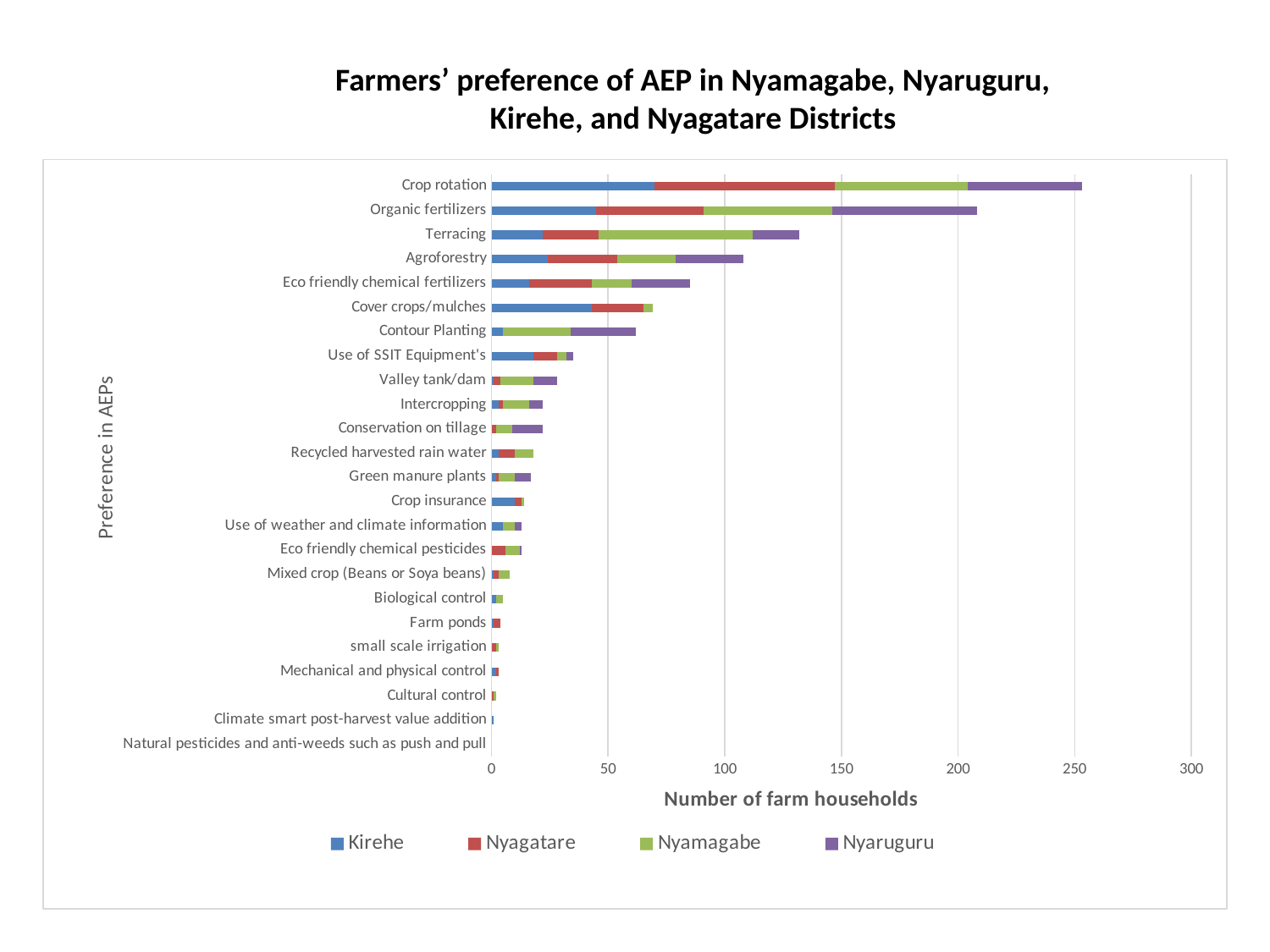
What kind of chart is shown on the slide? Stacked bar chart Which practice has the highest total number of farm households? Crop rotation Which has a larger total, Eco friendly chemical fertilizers or Cover crops/mulches? Eco friendly chemical fertilizers Is the total value for Terracing greater or less than 150? less Is the total value for Crop rotation greater or less than 200? greater Which has a larger total, Terracing or Agroforestry? Terracing Do the total bar lengths increase or decrease going from the top category to the bottom category? decrease What is the title of the x axis? Number of farm households How many series does the legend list? 4 Which practice has the lowest total number of farm households? Natural pesticides and anti-weeds such as push and pull Is the total value for Agroforestry greater or less than 100? greater How many agricultural practice categories are plotted on the y axis? 24